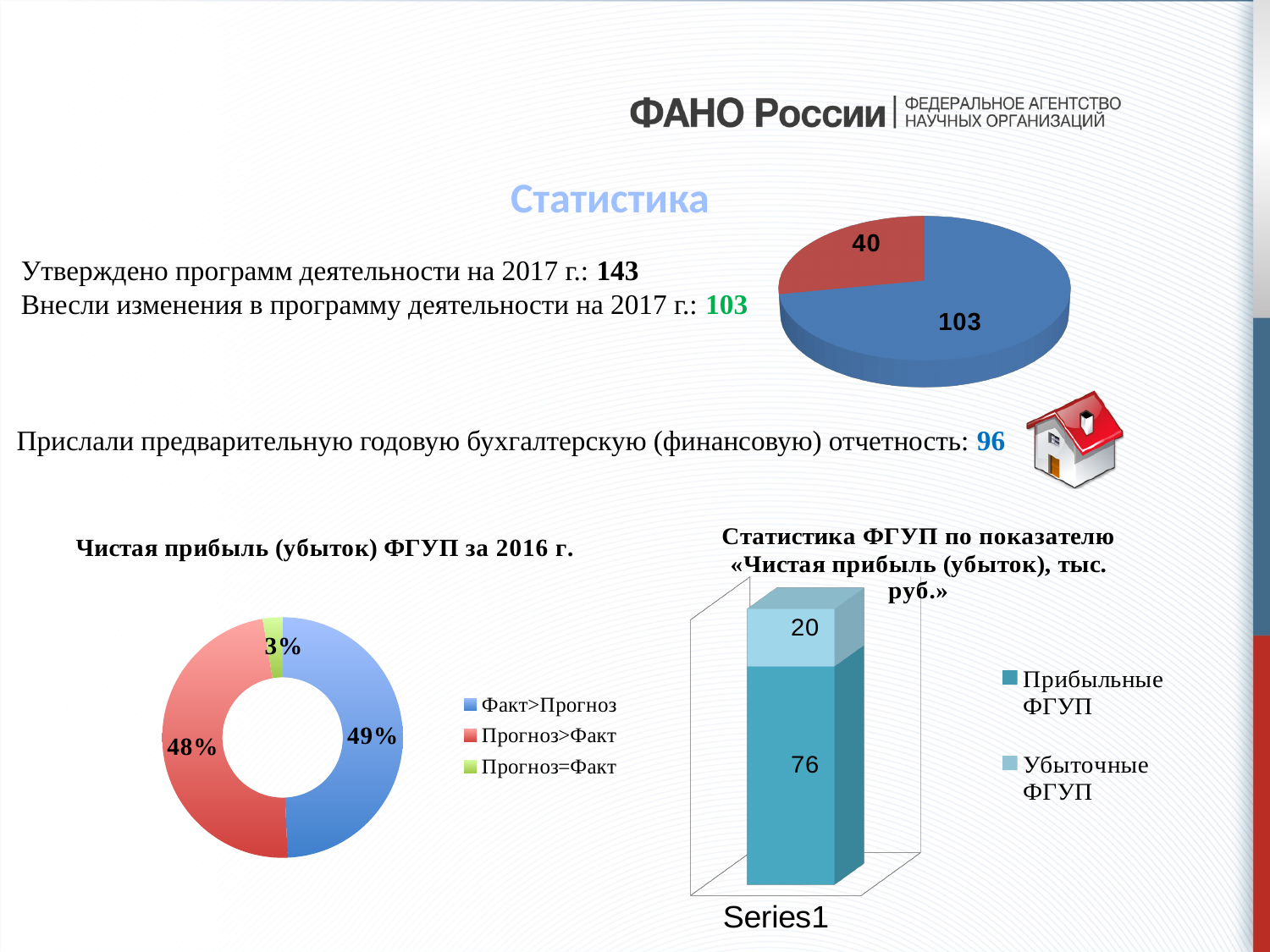
In the chart 'Статистика ФГУП по показателю «Чистая прибыль (убыток), тыс. руб.»', what is the total of the stacked bar? 96 In the pie chart at the top right of the slide, what is the value of the smaller (red) slice? 40 In the pie chart at the top right of the slide, what is the difference between the two slice values? 63 In the chart 'Статистика ФГУП по показателю «Чистая прибыль (убыток), тыс. руб.»', what is the value for Прибыльные ФГУП? 76 In the chart 'Чистая прибыль (убыток) ФГУП за 2016 г.', which category has the smallest share? Прогноз=Факт In the pie chart at the top right of the slide, what is the value of the larger (blue) slice? 103 In the pie chart at the top right of the slide, how many slices are there? 2 What kind of chart is 'Чистая прибыль (убыток) ФГУП за 2016 г.'? Doughnut chart In the chart 'Чистая прибыль (убыток) ФГУП за 2016 г.', what share is shown for Прогноз=Факт? 3% In the chart 'Чистая прибыль (убыток) ФГУП за 2016 г.', what share is shown for Факт>Прогноз? 49% In the chart 'Чистая прибыль (убыток) ФГУП за 2016 г.', how many entries does the legend list? 3 In the chart 'Статистика ФГУП по показателю «Чистая прибыль (убыток), тыс. руб.»', which is larger: Прибыльные ФГУП or Убыточные ФГУП? Прибыльные ФГУП